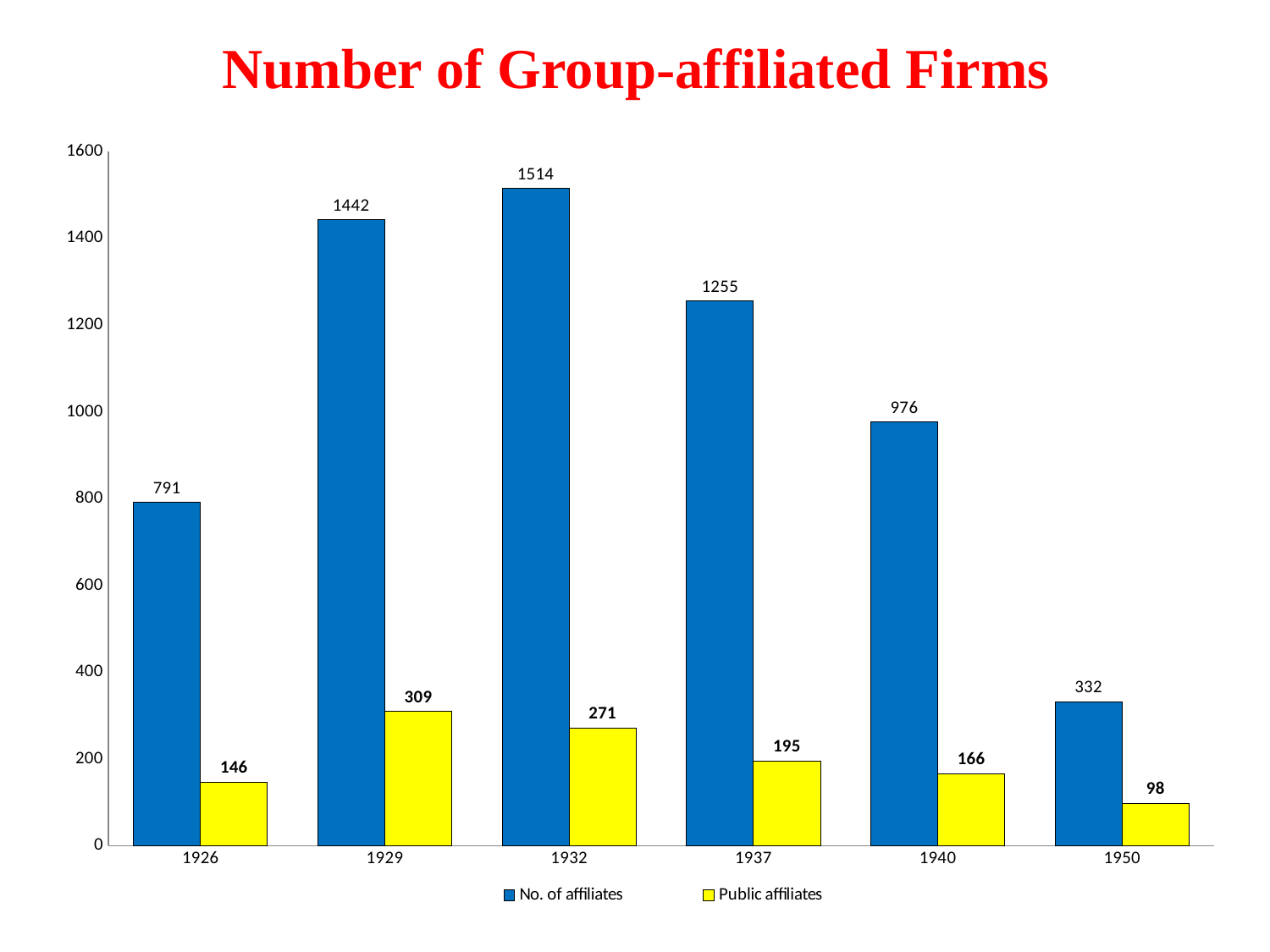
How many series does the legend list? 2 Which year has the highest value for No. of affiliates? 1932 Do the values for Public affiliates rise or fall from 1929 to 1950? fall What kind of chart is shown on the slide? bar chart Is the value for No. of affiliates in 1940 greater or less than 1000? less How many years are shown on the x axis? 6 What is the difference between No. of affiliates in 1932 and in 1929? 72 What is the value for No. of affiliates in 1932? 1514 What is the value for Public affiliates in 1929? 309 Which is larger: Public affiliates in 1937 or Public affiliates in 1940? Public affiliates in 1937 Which year has the lowest value for Public affiliates? 1950 What is the difference between No. of affiliates and Public affiliates in 1950? 234